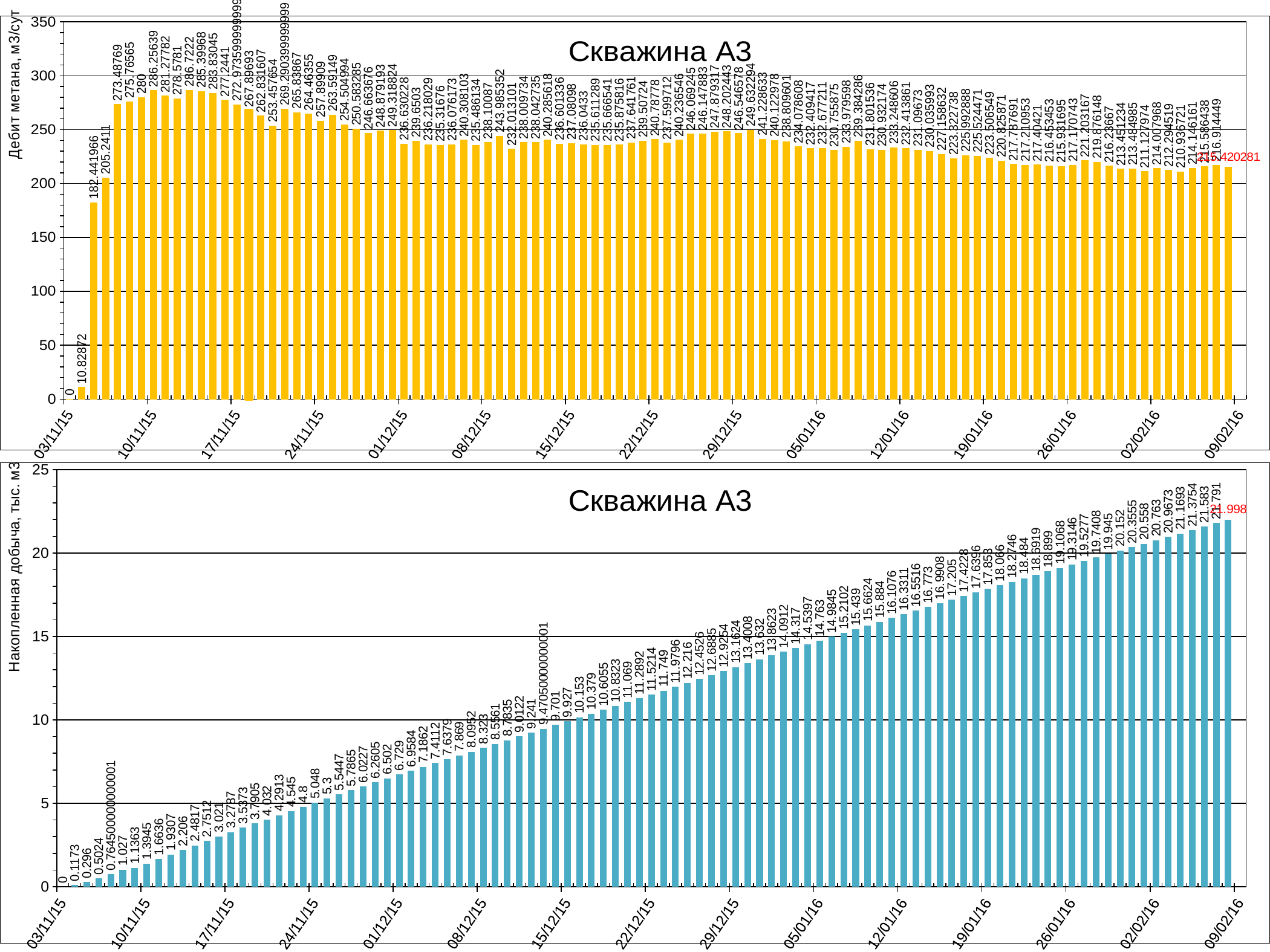
In the top chart (Дебит метана), what is the value of the second bar, right after 03/11/15? 10.82872 In the top chart (Дебит метана), what is the value of the last bar, at 09/02/16? 215.420281 In the top chart (Дебит метана), what is the highest value printed on a bar? 286.7222 What colour are the bars in the bottom chart? blue What kind of chart is the top chart titled "Скважина А3"? bar chart What is the y-axis title of the top chart? Дебит метана, м3/сут In the bottom chart (Накопленная добыча), what is the value of the last bar, at 09/02/16? 21.998 In the bottom chart (Накопленная добыча), is the value at 01/12/15 greater or less than 5? greater In the top chart (Дебит метана), which is larger: the value at 10/11/15 or the value at 09/02/16? 10/11/15 In the top chart (Дебит метана), is the value at 09/02/16 greater or less than 200? greater In the bottom chart (Накопленная добыча), do the values rise or fall along the x axis from 03/11/15 to 09/02/16? rise In the bottom chart (Накопленная добыча), what is the difference between the last bar (21.998) and the bar before it (21.791)? 0.207